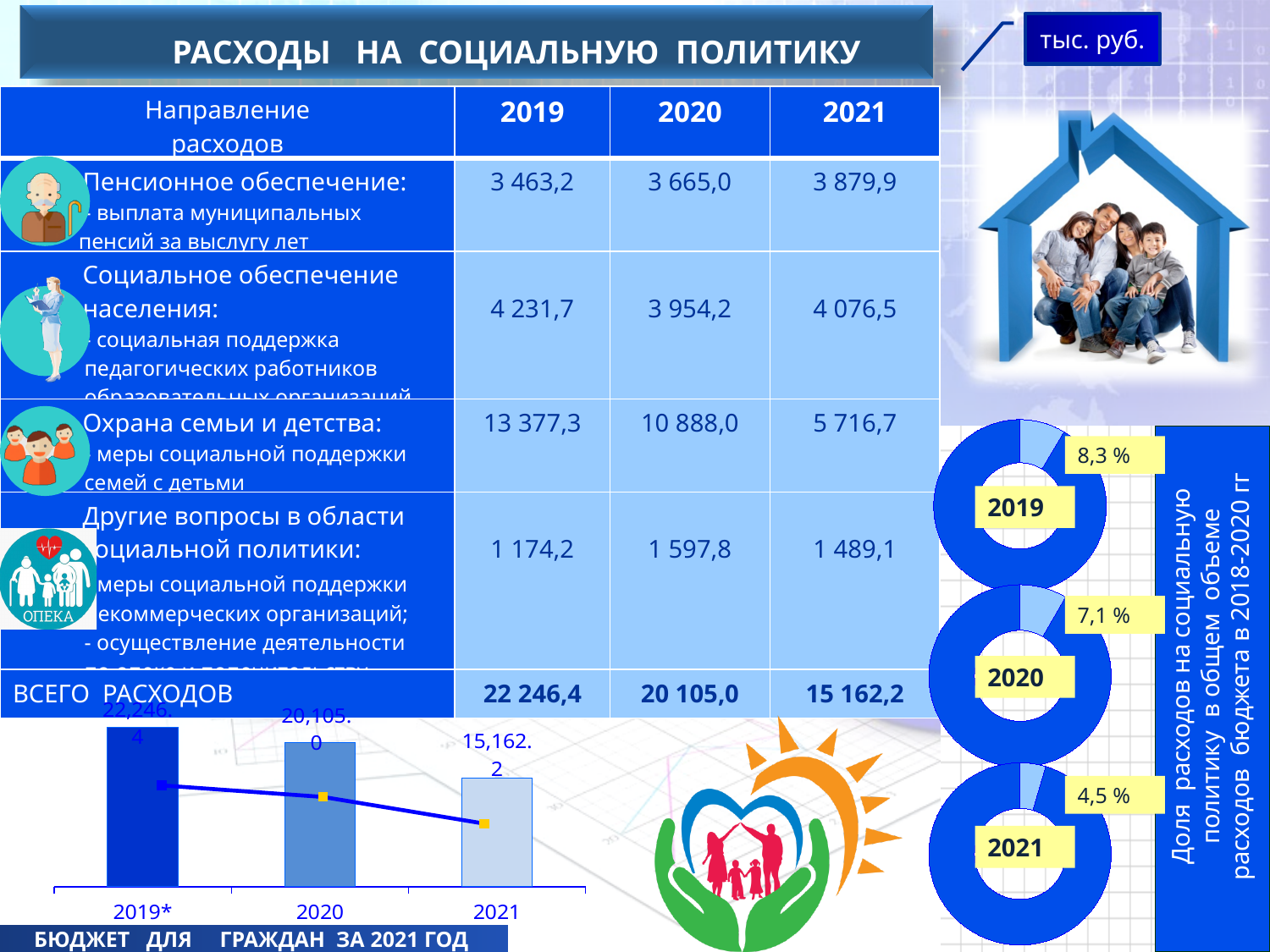
In the bar chart at the bottom left, how many bars are plotted? 3 In the bar chart at the bottom left, which year has the tallest bar? 2019* In the bar chart at the bottom left, what is the value labelled for 2020? 20,105.0 In the donut charts on the right, what share is shown for 2021? 4,5 % Among the donut charts on the right, which year shows the largest share? 2019 In the bar chart at the bottom left, do the values rise or fall from 2019* to 2021? fall In the donut charts on the right, what share is shown for 2019? 8,3 % In the bar chart at the bottom left, which year has the shortest bar? 2021 In the bar chart at the bottom left, what is the difference between the 2020 value and the 2021 value? 4,942.8 What kind of chart is shown at the bottom left of the slide? bar chart In the bar chart at the bottom left, what is the value labelled for 2021? 15,162.2 In the donut charts on the right, which year has the larger share, 2020 or 2021? 2020